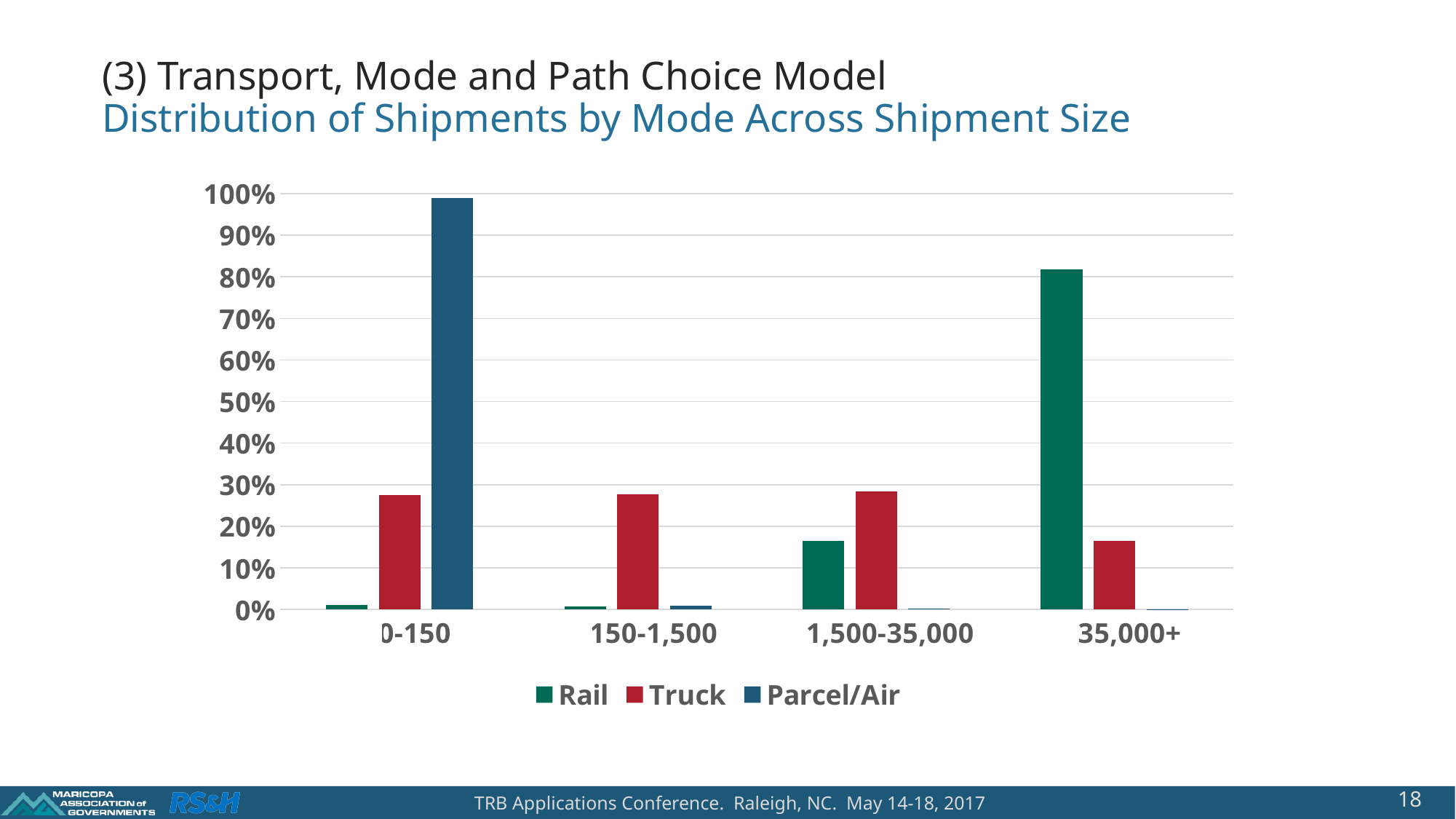
For the 35,000+ category, which is larger, Rail or Truck? Rail For the 1,500-35,000 category, which is larger, Rail or Truck? Truck Which shipment size category has the lowest Truck share? 35,000+ What kind of chart is shown on the slide? bar chart Is the Rail value for 35,000+ greater or less than 70%? greater Is the Parcel/Air value for 0-150 greater or less than 90%? greater How many series does the legend list? 3 Which shipment size category has the highest Rail share? 35,000+ How many shipment size categories are shown on the x axis? 4 Which shipment size category has the highest Parcel/Air share? 0-150 Is the Truck value for 0-150 greater or less than 30%? less